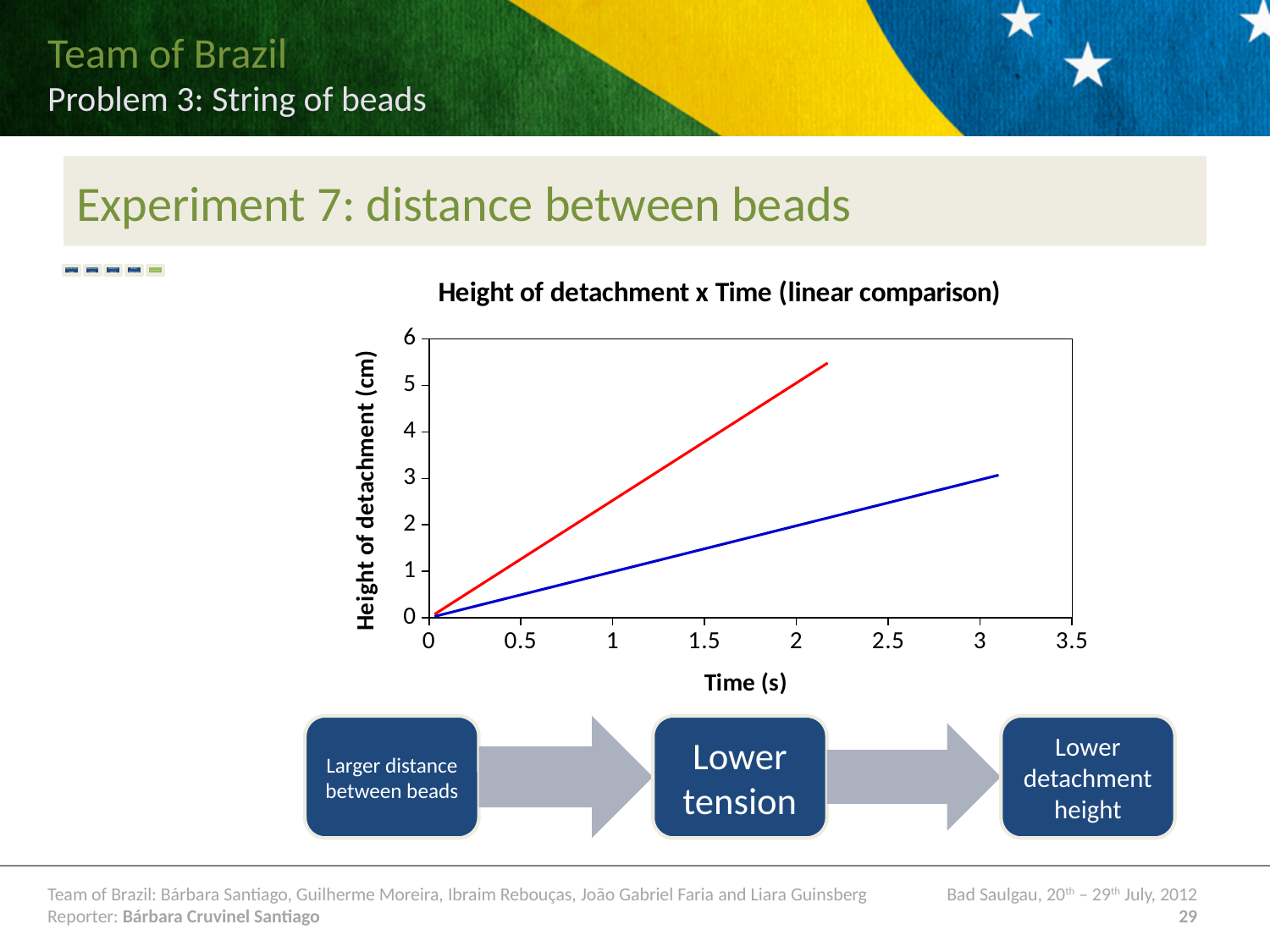
What kind of chart is shown on the slide? line chart At a time of 2 s, is the height of detachment for the red line greater or less than 4 cm? greater Does the height of detachment rise or fall as time increases for the blue line? rise What is the title of the chart? Height of detachment x Time (linear comparison) At a time of 1 s, is the height of detachment for the red line greater or less than 2 cm? greater What is the label of the vertical axis of the chart? Height of detachment (cm) Which line extends to a later time on the x axis, the red line or the blue line? blue line At a time of 2.5 s, is the height of detachment for the blue line greater or less than 2 cm? greater Which line reaches the greater height of detachment, the red line or the blue line? red line Does the height of detachment rise or fall as time increases for the red line? rise How many lines are plotted on the chart? 2 At a time of 2 s, which line shows the larger height of detachment, the red line or the blue line? red line